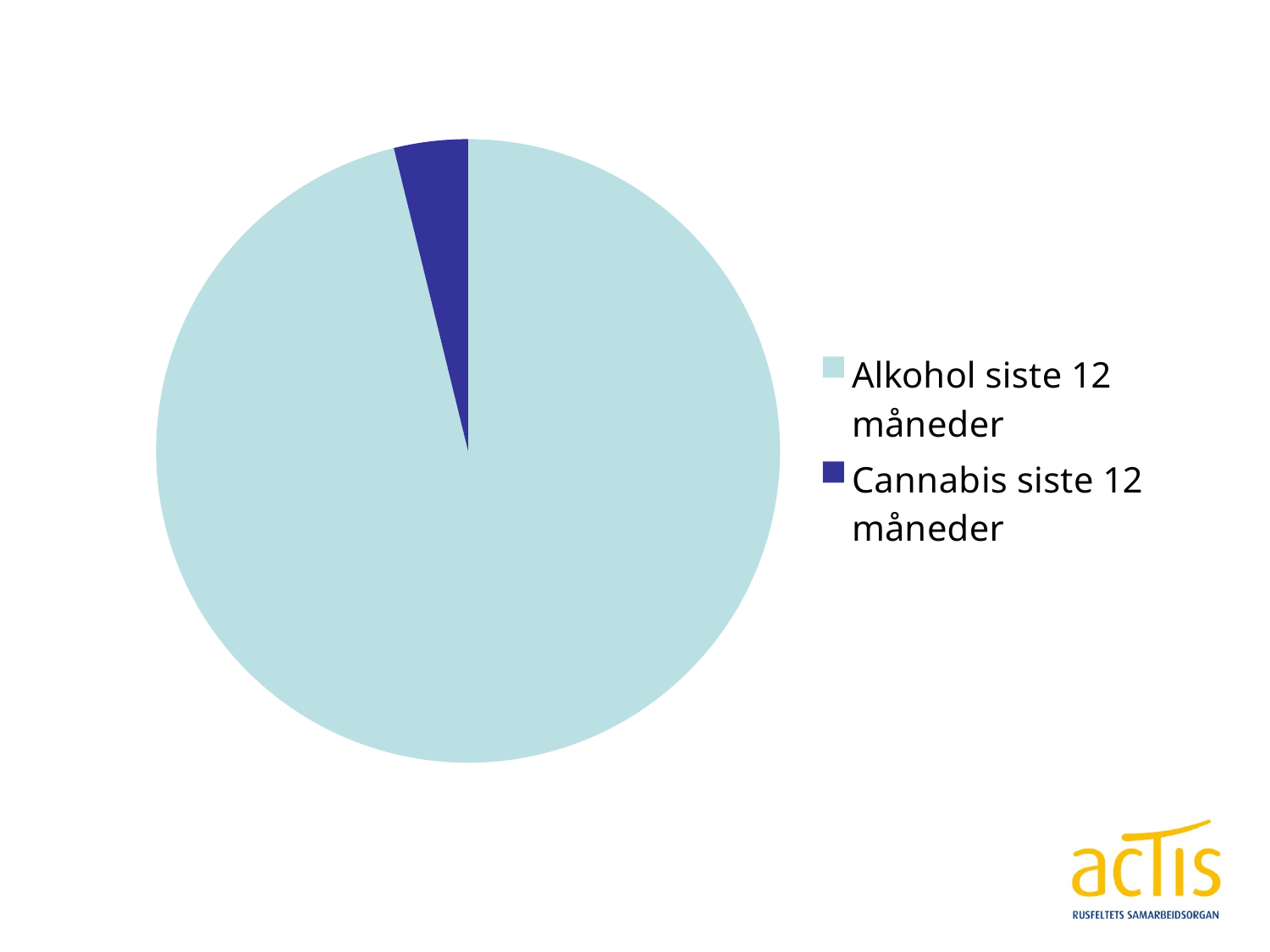
What colour is the slice for Cannabis siste 12 måneder? dark blue Which is larger, the slice for Alkohol siste 12 måneder or the slice for Cannabis siste 12 måneder? Alkohol siste 12 måneder Which slice of the pie chart is the largest? Alkohol siste 12 måneder How many entries does the legend list? 2 Which slice of the pie chart is the smallest? Cannabis siste 12 måneder What colour is the slice for Alkohol siste 12 måneder? light blue What kind of chart is shown on the slide? pie chart How many slices does the pie chart have? 2